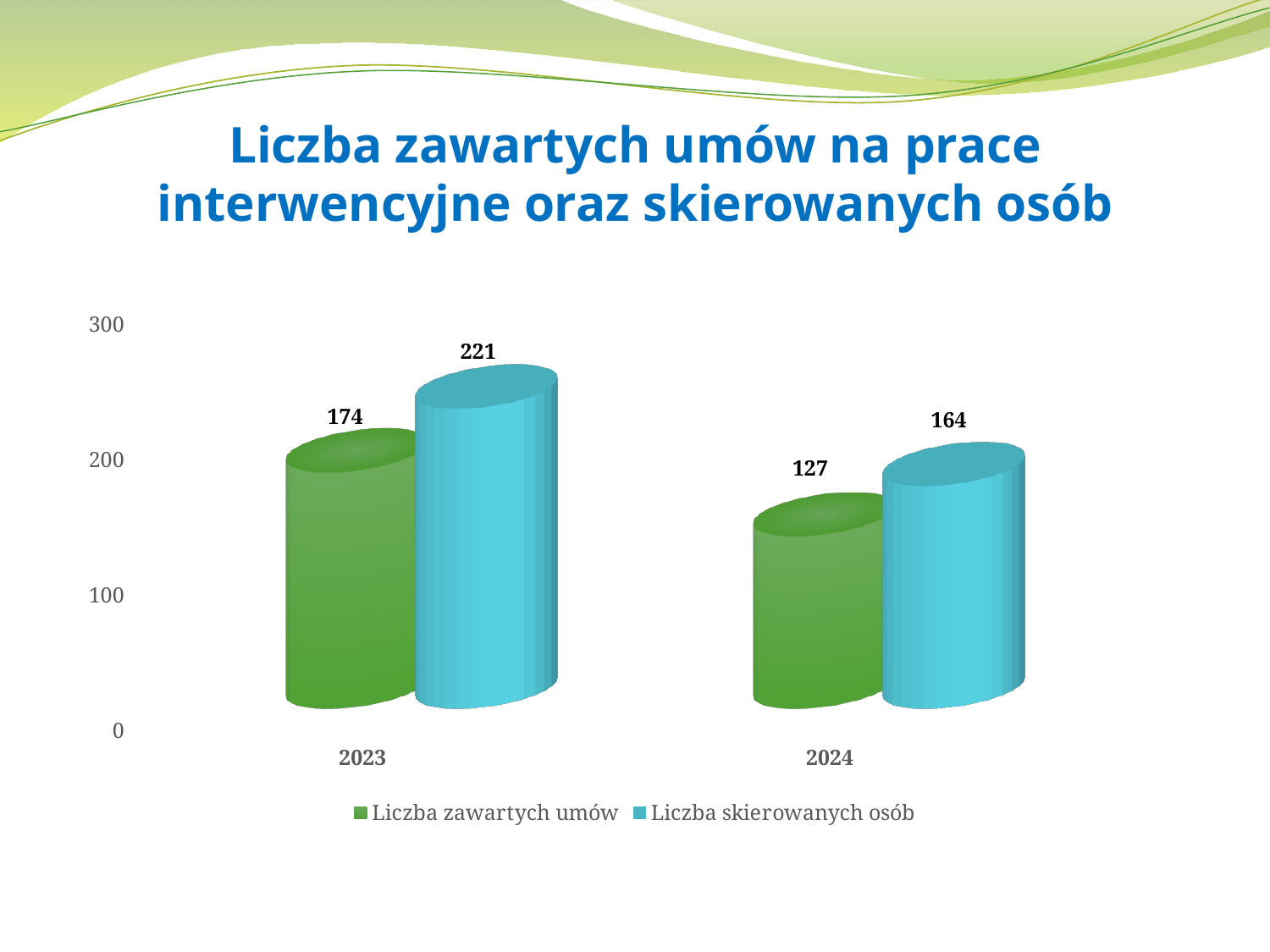
What is the value of Liczba zawartych umów for 2023? 174 What kind of chart is shown on the slide? Bar chart What is the difference between Liczba skierowanych osób and Liczba zawartych umów in 2023? 47 How many series does the legend list? 2 Which is larger: Liczba zawartych umów in 2023 or Liczba skierowanych osób in 2024? Liczba zawartych umów in 2023 What is the value of Liczba zawartych umów for 2024? 127 By how much did Liczba zawartych umów decrease from 2023 to 2024? 47 Do the values for Liczba skierowanych osób rise or fall from 2023 to 2024? Fall What is the value of Liczba skierowanych osób for 2024? 164 Which year has the lower value for Liczba zawartych umów? 2024 What is the value of Liczba skierowanych osób for 2023? 221 Which year has the higher value for Liczba skierowanych osób? 2023